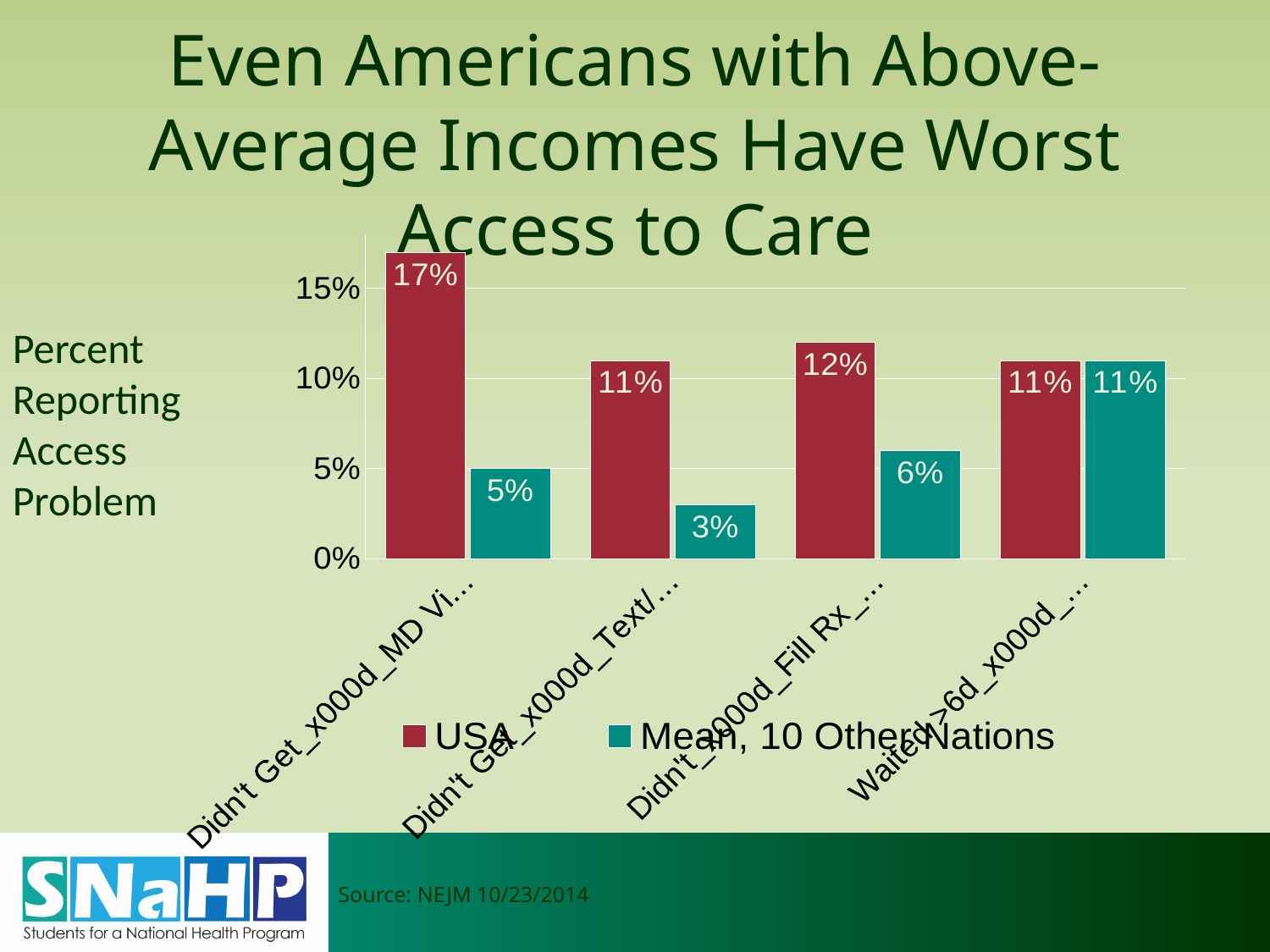
Which category has the lowest value for Mean, 10 Other Nations? The second category from the left (Didn't Get Text/…) Which category has the highest USA value? The first category from the left (Didn't Get MD Vi…) In the third category from the left, which series has the larger value, USA or Mean, 10 Other Nations? USA How many series does the legend list? 2 What is the USA value for the fourth (rightmost) category? 11% What type of chart is shown on the slide? Bar chart What is the value for Mean, 10 Other Nations in the second category from the left? 3% What is the value for Mean, 10 Other Nations in the third category from the left? 6% How many categories are shown on the x axis? 4 In the third category from the left, what is the difference between the USA value and the Mean, 10 Other Nations value? 6 percentage points In the first category from the left, how much higher is the USA value than the Mean, 10 Other Nations value? 12 percentage points What is the USA value for the first category from the left? 17%